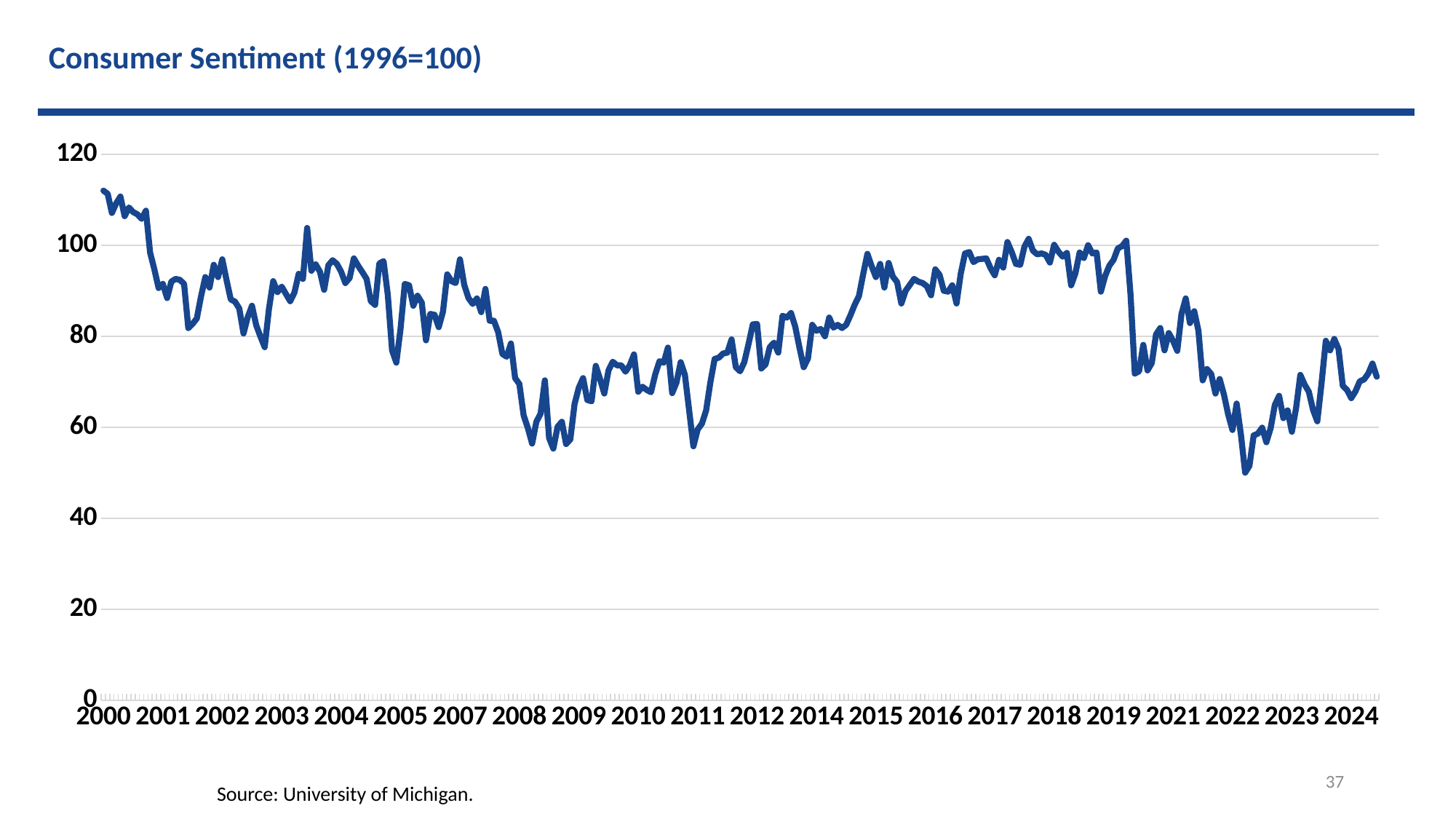
What is the source cited for the chart? University of Michigan Does consumer sentiment rise or fall between 2019 and 2022? fall Is the consumer sentiment value at the start of 2000 greater or less than 100? greater Is the consumer sentiment value at the end of 2024 greater or less than 80? less Is the lowest consumer sentiment value in 2009 greater or less than 60? less Does consumer sentiment rise or fall between 2011 and 2015? rise In which year does consumer sentiment reach its lowest level on the chart? 2022 What kind of chart is shown on the slide? line chart In which year does consumer sentiment reach its highest level on the chart? 2000 What is the title of the chart? Consumer Sentiment (1996=100)